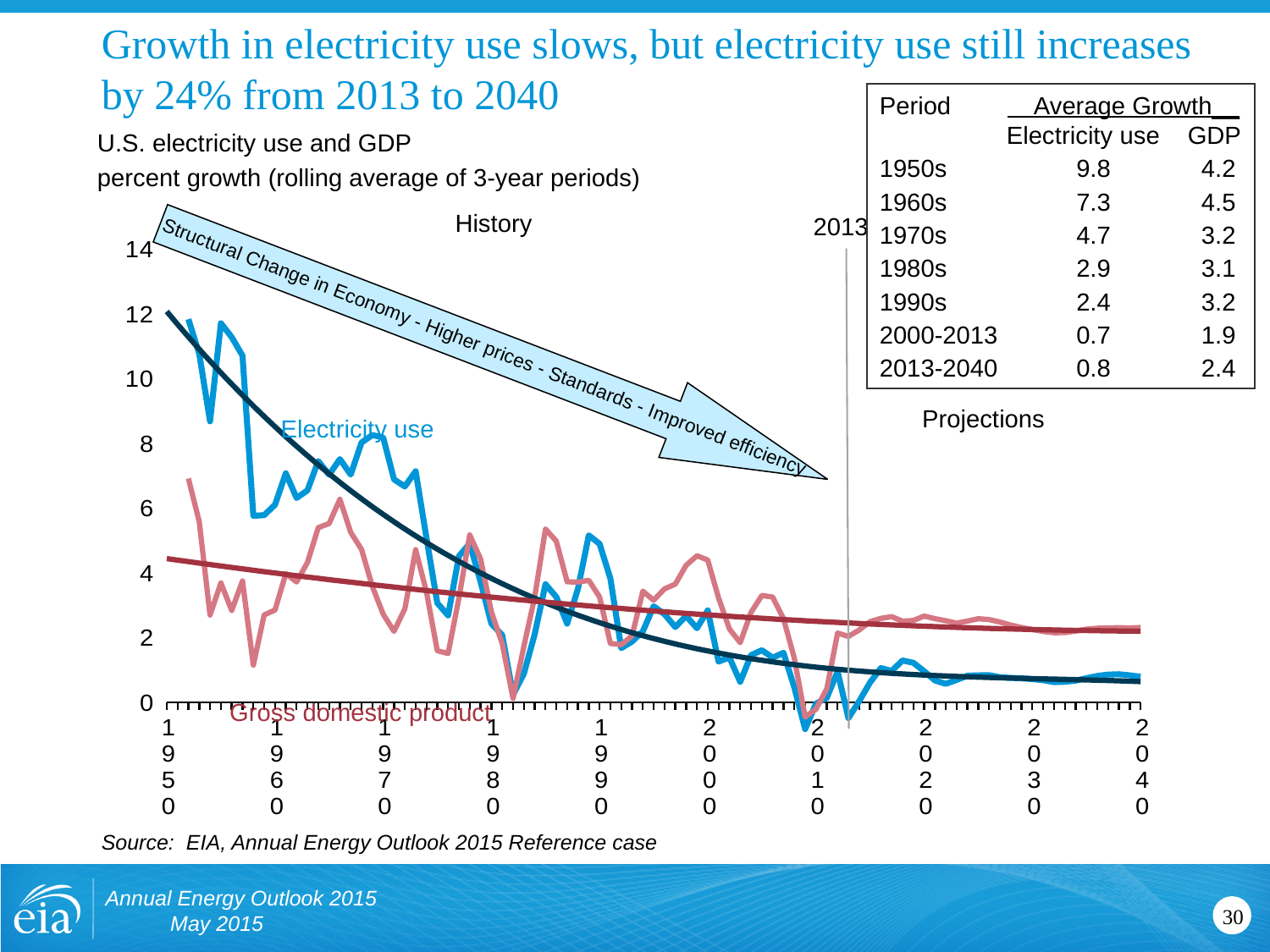
Is the Electricity use value at the start of the chart (around 1950) greater or less than 10? greater What year does the vertical line separating History from Projections mark? 2013 What kind of chart is shown on the slide? line chart Is the Gross domestic product value at the start of the chart (around 1950) greater or less than 8? less Around 2040, which series has the higher growth rate, Electricity use or Gross domestic product? Gross domestic product What is the highest value shown on the chart's vertical axis? 14 Is the Electricity use value at the end of the chart (around 2040) greater or less than 2? less According to the table on the slide, what was the average growth in electricity use in the 1950s? 9.8 How many year labels are shown along the x axis of the chart? 10 What are the two data series plotted in the chart? Electricity use and Gross domestic product Does the Electricity use line generally rise or fall from 1950 to 2040? fall Around 1950, which series has the higher growth rate, Electricity use or Gross domestic product? Electricity use